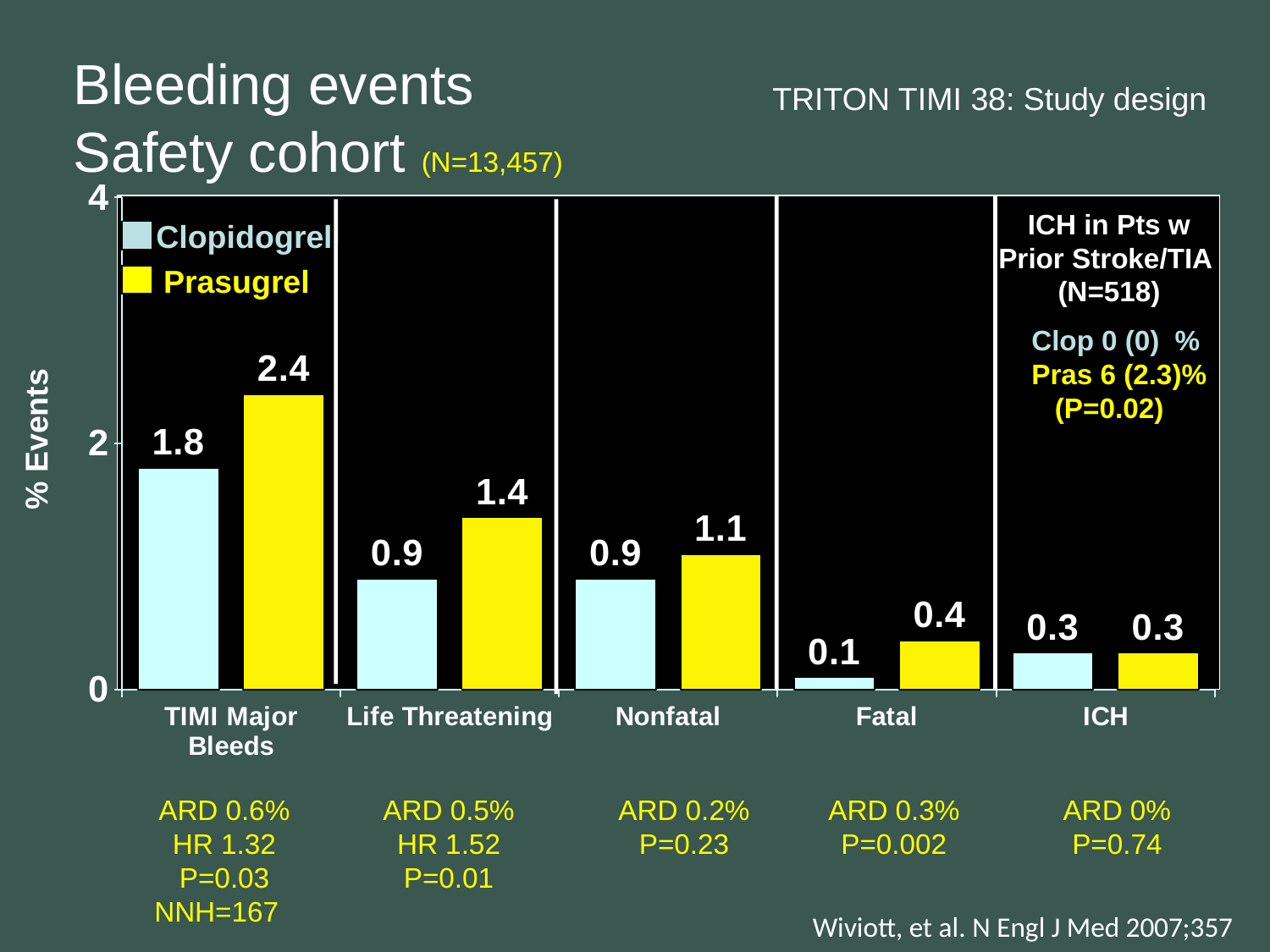
Which is larger in the Nonfatal category, the Clopidogrel value or the Prasugrel value? Prasugrel What is the value for Prasugrel in the Fatal category? 0.4 What is the value for Clopidogrel in the Life Threatening category? 0.9 What is the label of the y axis? % Events What is the difference between the Prasugrel and Clopidogrel values for TIMI Major Bleeds? 0.6 How many series does the legend list? 2 How many categories are shown on the x axis? 5 What kind of chart is shown on the slide? Bar chart Which category has the lowest Clopidogrel value? Fatal What is the value for Prasugrel in the TIMI Major Bleeds category? 2.4 Which category has the highest Clopidogrel value? TIMI Major Bleeds What is the difference between the Prasugrel and Clopidogrel values for Life Threatening? 0.5